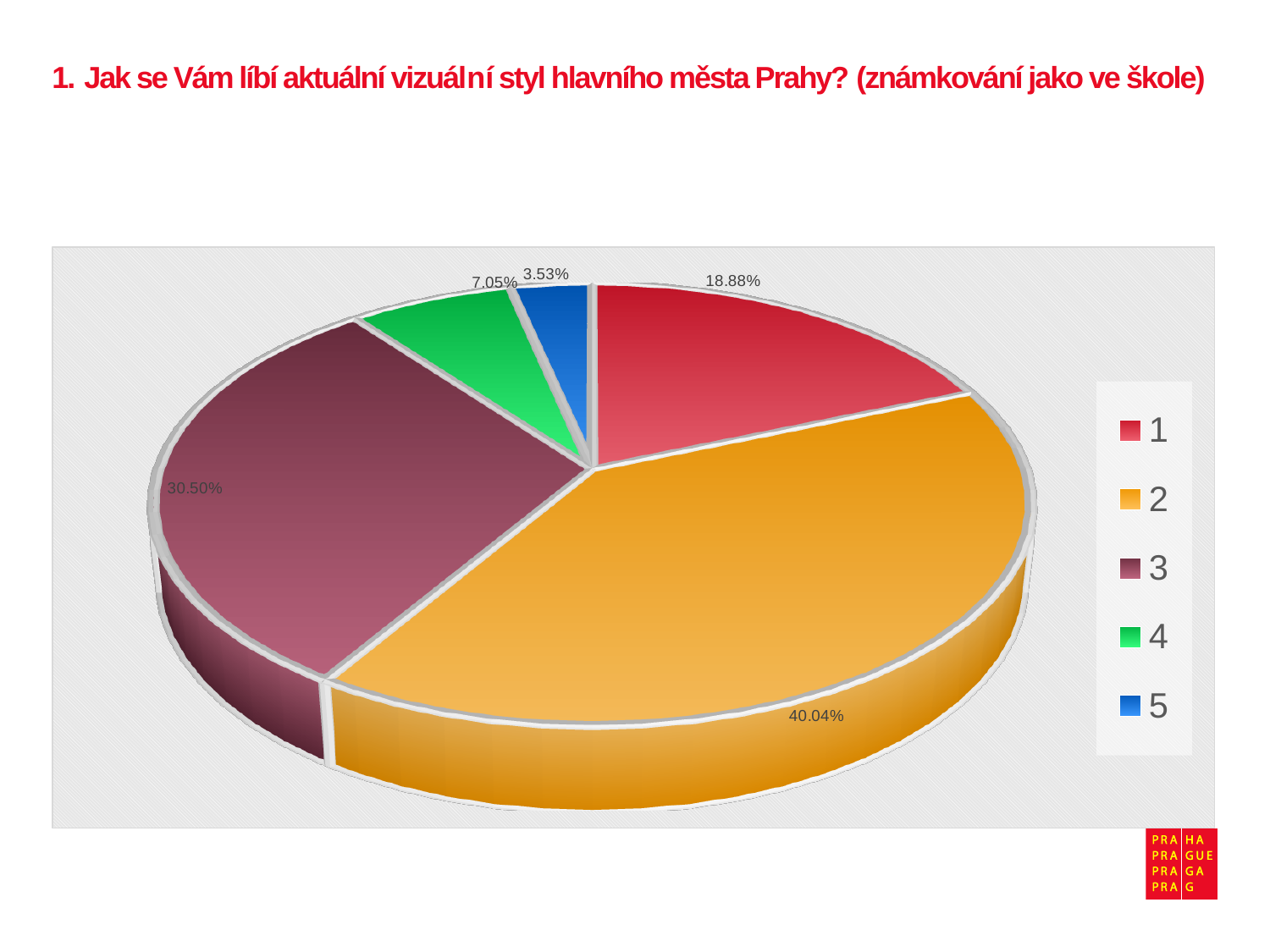
What percentage of respondents gave grade 1? 18.88% What kind of chart is shown on the slide? pie chart How many entries does the legend list? 5 How many slices does the pie chart have? 5 Which has a larger share, grade 1 or grade 4? 1 What percentage of respondents gave grade 2? 40.04% What is the difference in percentage points between grade 2 and grade 3? 9.54 What colour is the slice for grade 4? green Which grade has the smallest share of the pie? 5 What percentage of respondents gave grade 5? 3.53% Which grade has the largest share of the pie? 2 What percentage of respondents gave grade 3? 30.50%